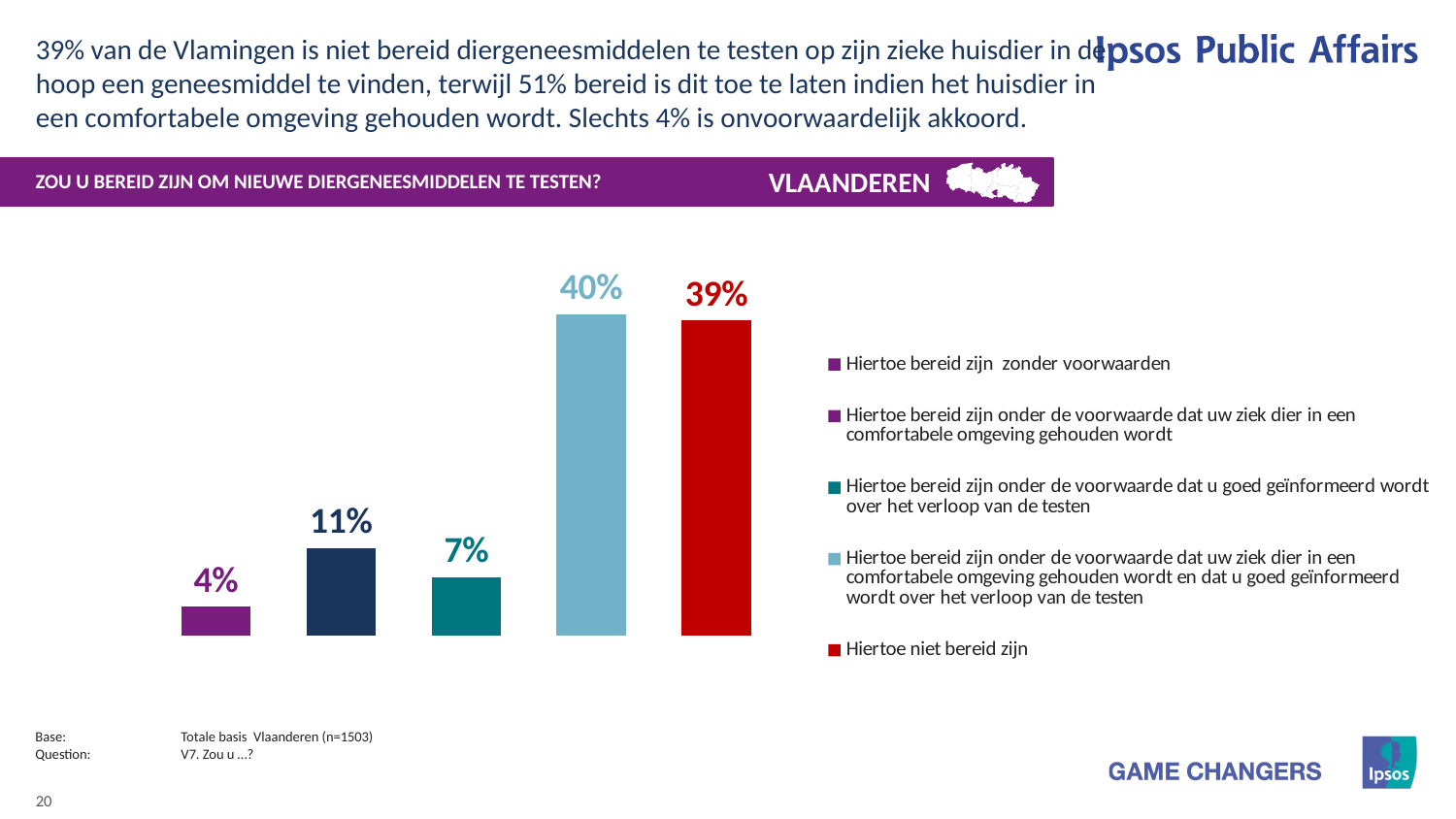
What percentage are willing on the condition that they are well informed about the course of the tests? 7% What is the difference in percentage points between the 'comfortable environment' condition (11%) and the 'well informed' condition (7%)? 4 How many bars are shown in the chart? 5 Which response category has the lowest percentage? Hiertoe bereid zijn zonder voorwaarden What type of chart is shown on the slide? Bar chart What percentage are willing on the condition that the sick animal is kept in a comfortable environment? 11% Which is larger: the share willing without conditions or the share willing on the condition of being well informed about the tests? Willing on the condition of being well informed (7%) What percentage of respondents are willing without conditions ("Hiertoe bereid zijn zonder voorwaarden")? 4% What percentage are willing on the condition that the animal is kept in a comfortable environment and they are well informed about the tests? 40% How many entries does the legend list? 5 Which response category has the highest percentage? Hiertoe bereid zijn onder de voorwaarde dat uw ziek dier in een comfortabele omgeving gehouden wordt en dat u goed geïnformeerd wordt over het verloop van de testen What percentage of respondents are not willing to test new veterinary medicines ("Hiertoe niet bereid zijn")? 39%